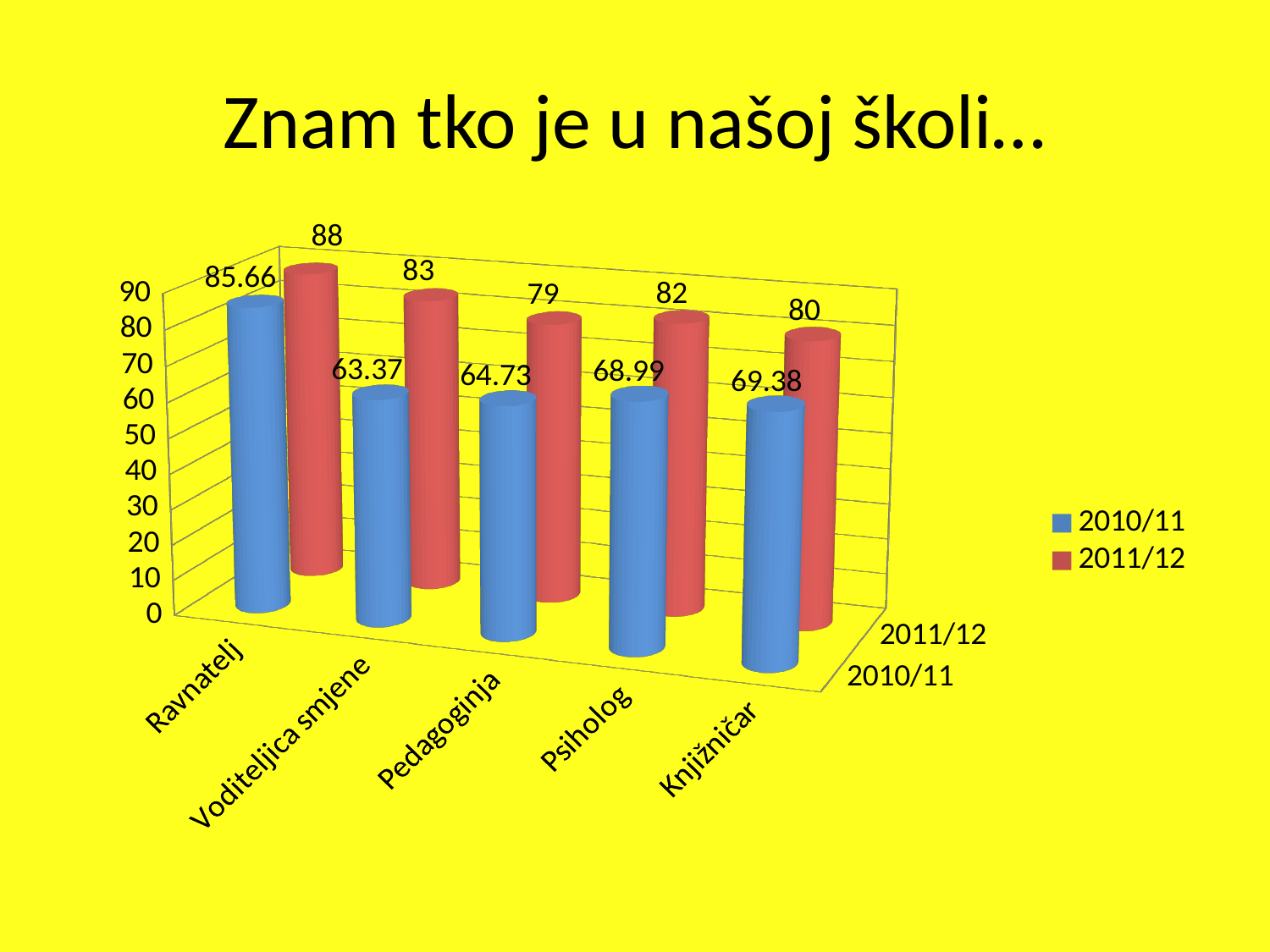
How many categories are shown on the x axis? 5 What is the value for Ravnatelj in the 2010/11 series? 85.66 How many series does the legend list? 2 Which category has the highest value in the 2011/12 series? Ravnatelj What is the difference between the 2011/12 and 2010/11 values for Pedagoginja? 14.27 Which category has the lowest value in the 2010/11 series? Voditeljica smjene What kind of chart is shown on the slide? Bar chart What is the value for Knjižničar in the 2010/11 series? 69.38 What is the value for Voditeljica smjene in the 2010/11 series? 63.37 What is the value for Psiholog in the 2011/12 series? 82 Which is larger for Psiholog: the 2010/11 value or the 2011/12 value? 2011/12 What is the value for Ravnatelj in the 2011/12 series? 88